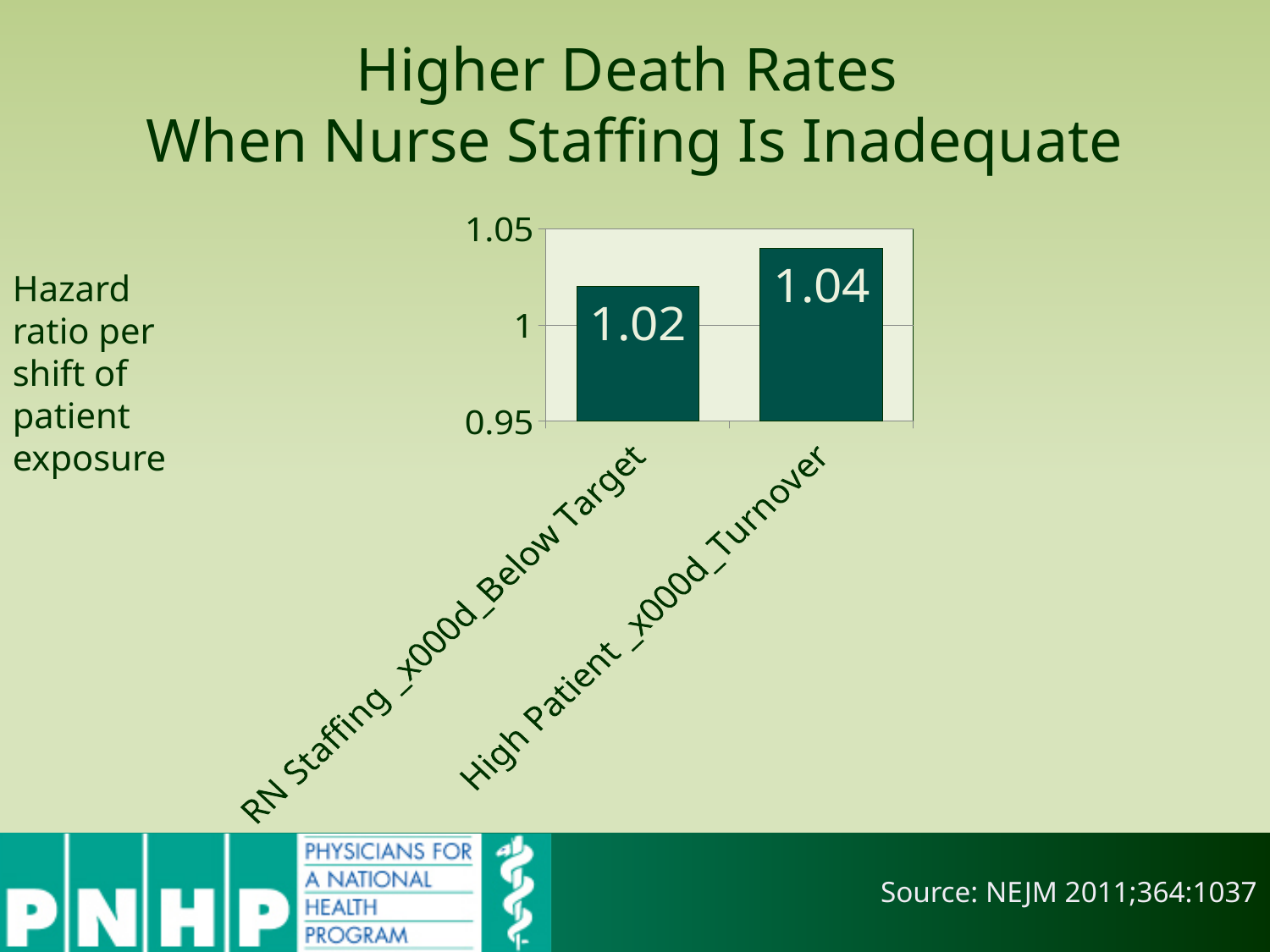
Is the value for RN Staffing Below Target greater or less than 1.05? less What is the lowest value shown on the vertical axis of the chart? 0.95 Is the hazard ratio for RN Staffing Below Target larger or smaller than that for High Patient Turnover? smaller Which category has the lower hazard ratio? RN Staffing Below Target What is the hazard ratio for RN Staffing Below Target? 1.02 What kind of chart is shown on the slide? bar chart How many categories are shown in the chart? 2 Which category has the higher hazard ratio? High Patient Turnover Is the value for High Patient Turnover greater or less than 1? greater What is the hazard ratio for High Patient Turnover? 1.04 What is the difference between the hazard ratios for High Patient Turnover and RN Staffing Below Target? 0.02 What is the title of the slide containing the chart? Higher Death Rates When Nurse Staffing Is Inadequate